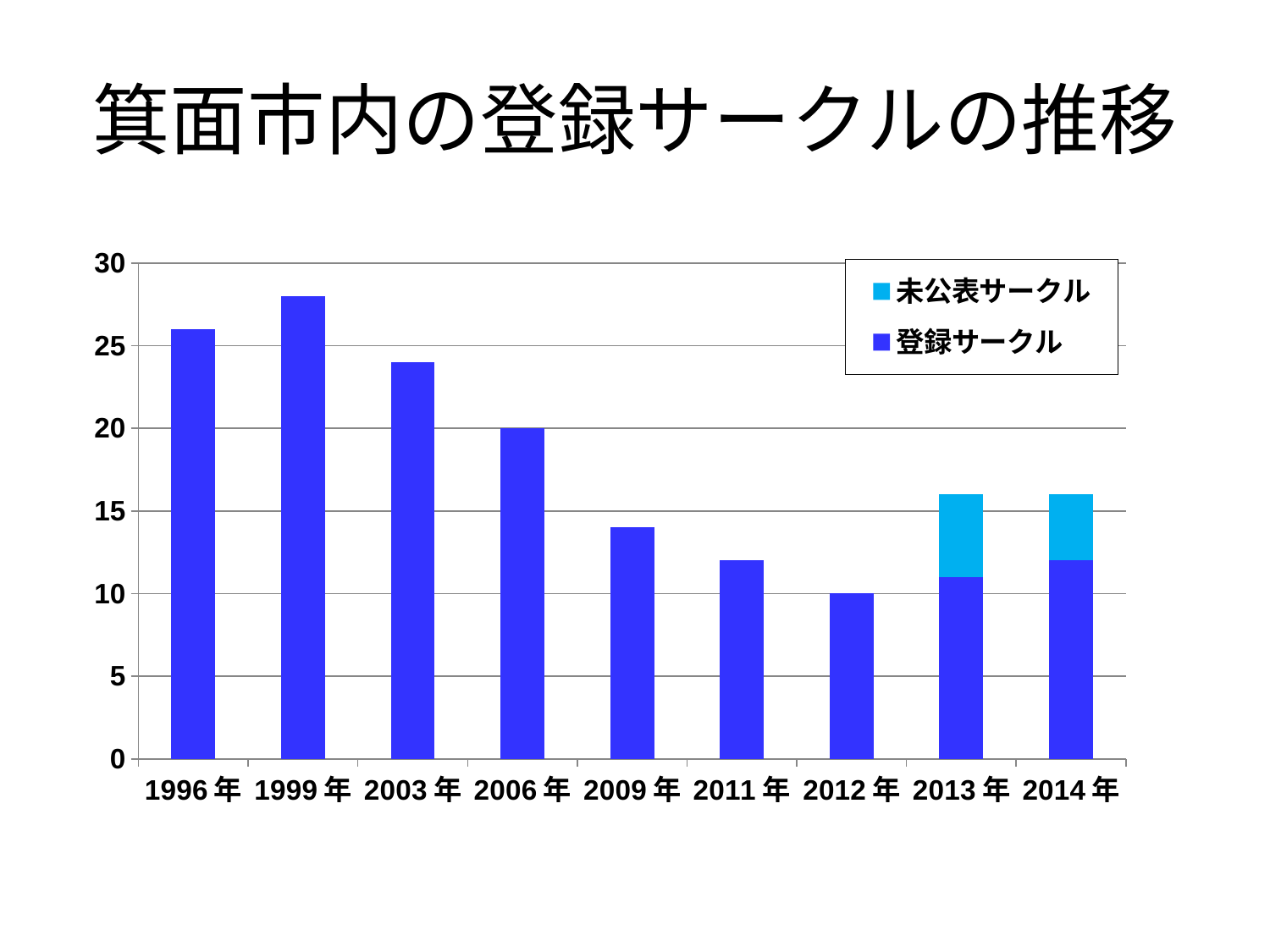
Is the value for 1999年 greater or less than 25? greater Which year has the highest bar? 1999年 Which year has the lowest bar? 2012年 What kind of chart is shown on the slide? bar chart How many series does the legend list? 2 What is the value for 2006年? 20 What is the title of the chart? 箕面市内の登録サークルの推移 Is the 登録サークル value for 2013年 greater or less than 15? less How many years are shown on the x axis? 9 What is the value for 2012年? 10 Which is larger, the value for 1996年 or the value for 2003年? 1996年 What is the difference between the values for 2006年 and 2012年? 10